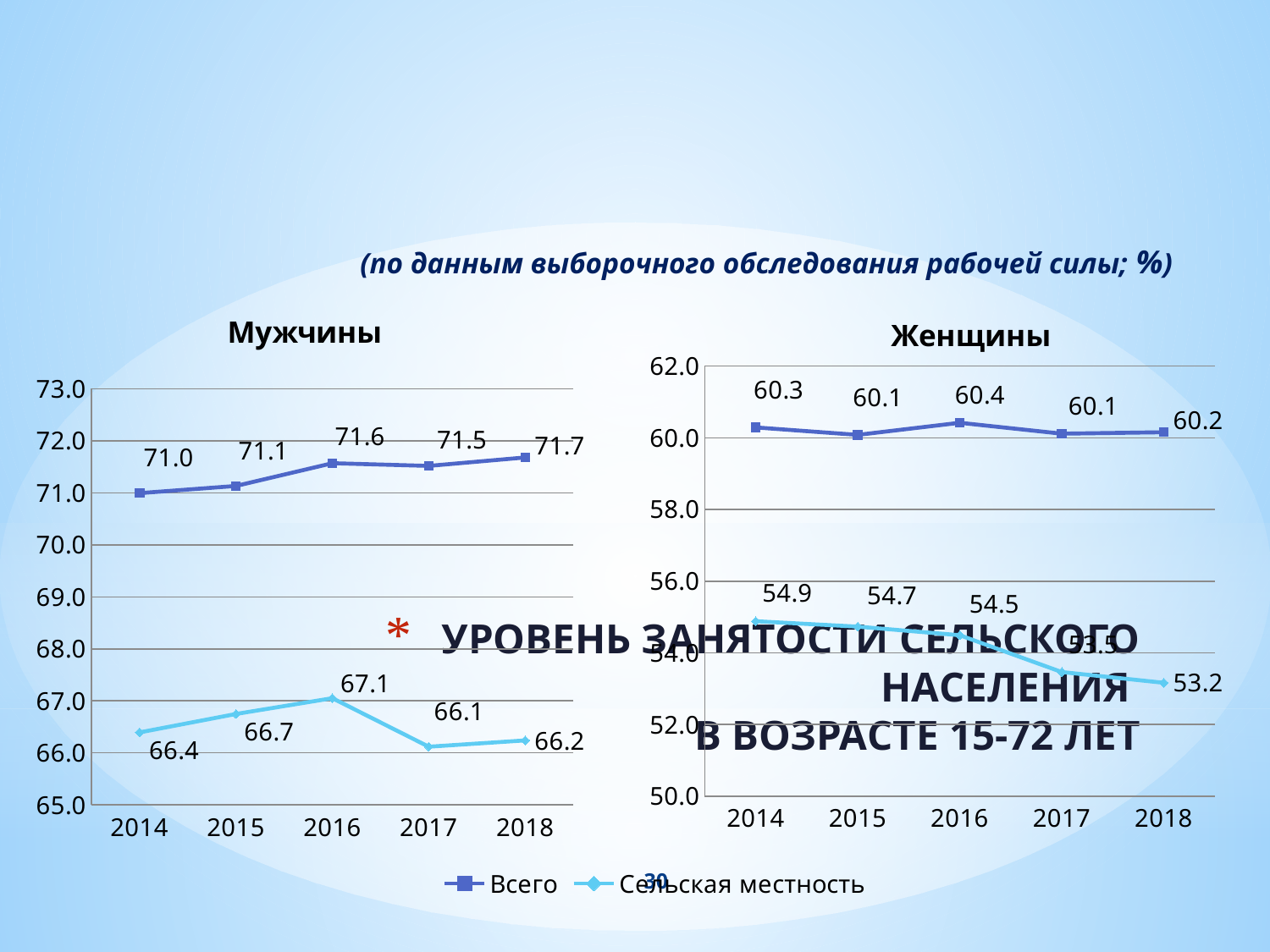
In the "Женщины" chart, does the "Сельская местность" series rise or fall from 2014 to 2018? fall In the "Женщины" chart, what is the value of the "Сельская местность" series for 2015? 54.7 In the "Мужчины" chart, what is the difference between the "Сельская местность" values for 2016 and 2017? 1.0 In the "Мужчины" chart, what is the value of the "Сельская местность" series for 2014? 66.4 In the "Женщины" chart, what is the difference between the "Всего" and "Сельская местность" values for 2014? 5.4 In the "Мужчины" chart, what is the value of the "Всего" series for 2016? 71.6 In the "Женщины" chart, what is the value of the "Всего" series for 2018? 60.2 How many years are shown on the x axis of the "Мужчины" chart? 5 In the "Женщины" chart, which is larger: the "Всего" value for 2016 or for 2015? 2016 In the "Мужчины" chart, in which year is the "Всего" series lowest? 2014 In the "Мужчины" chart, in which year is the "Сельская местность" series highest? 2016 How many series does the legend list? 2